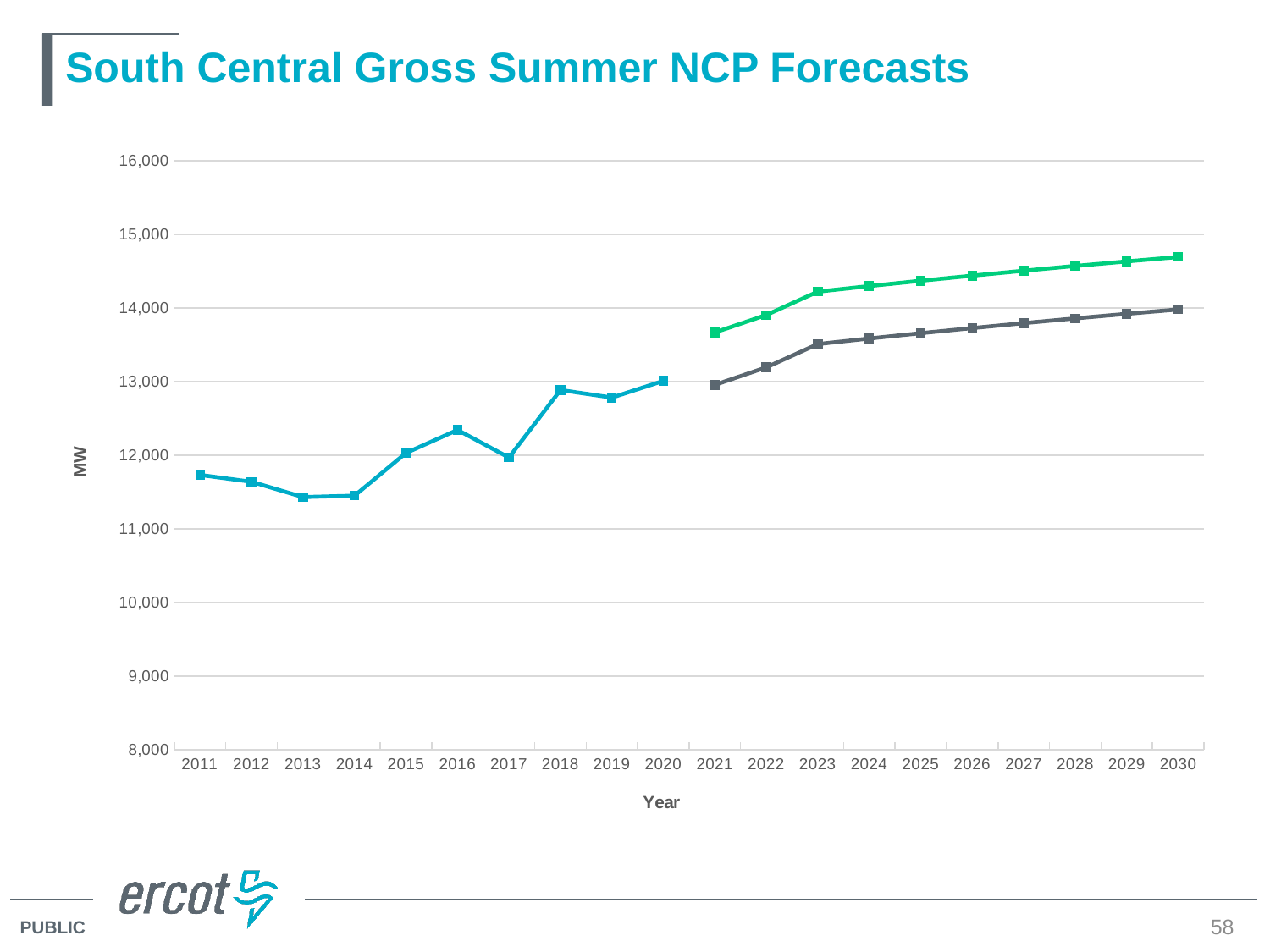
Is the value of the blue line for 2016 greater or less than 12,000? greater Is the value of the blue line for 2018 greater or less than 13,000? less Does the green line rise or fall from 2021 to 2030? rise Is the value of the dark gray line for 2023 greater or less than 13,000? greater What is the label of the vertical axis? MW How many years are shown on the x axis? 20 In 2025, which line has the higher value, the green line or the dark gray line? green line What is the title of the chart? South Central Gross Summer NCP Forecasts What kind of chart is shown on the slide? line chart